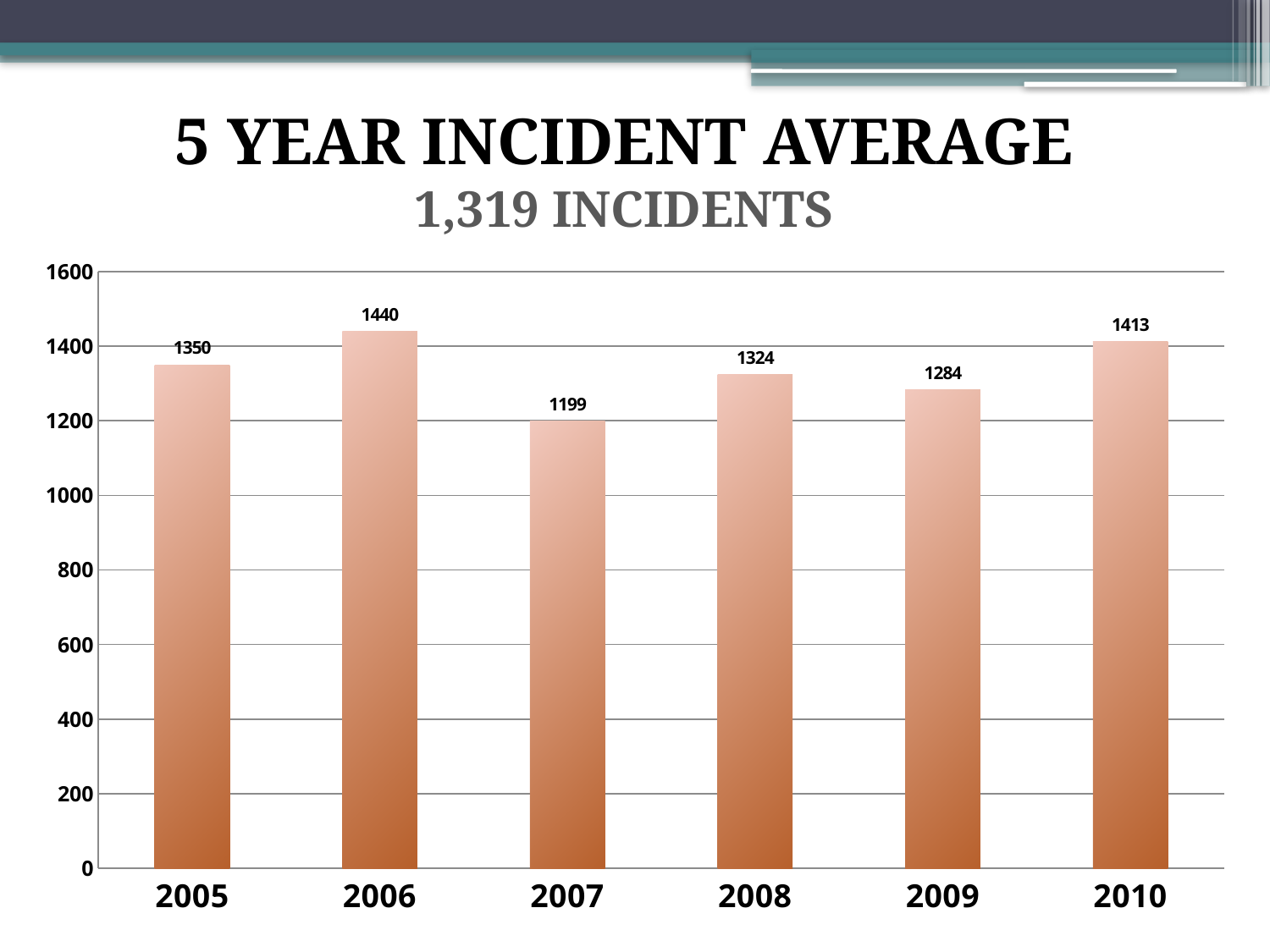
What is the value for 2010? 1413 What is the value for 2007? 1199 Which year has the highest value? 2006 What is the title of the slide? 5 YEAR INCIDENT AVERAGE What is the difference between the values for 2008 and 2009? 40 Which is larger, the value for 2005 or the value for 2009? 2005 Is the value for 2008 greater or less than 1200? greater How many years are shown on the x axis? 6 What kind of chart is shown on the slide? bar chart What is the difference between the values for 2006 and 2007? 241 What is the value for 2005? 1350 Which year has the lowest value? 2007